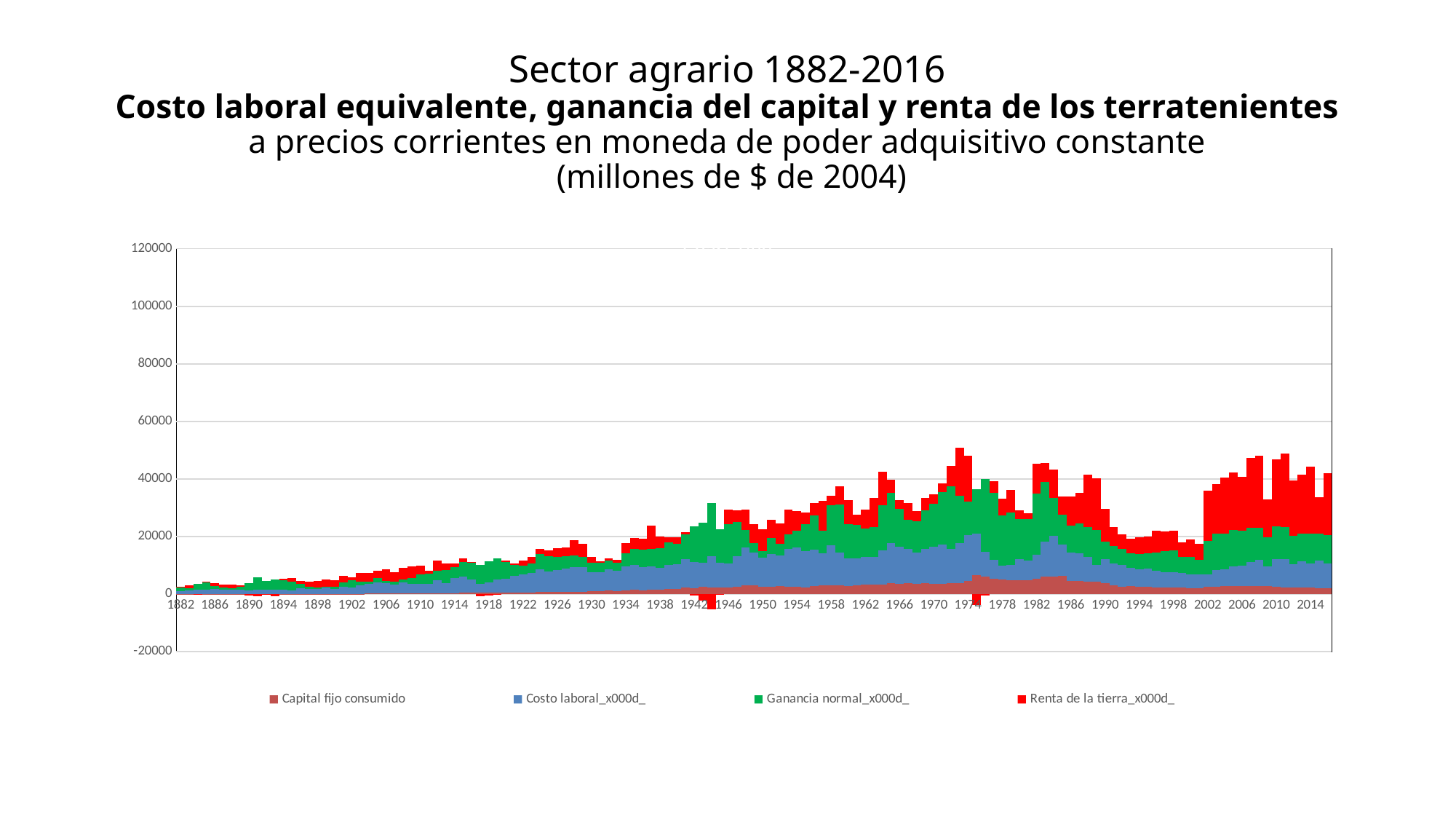
What is the highest value shown on the vertical axis? 120000 What kind of chart is shown on the slide? Stacked bar chart Which series is shown in red in the legend? Renta de la tierra_x000d_ Which series is shown in blue in the legend? Costo laboral_x000d_ What is the first year shown on the horizontal axis? 1882 How many series does the legend list? 4 Is the total stacked value for 1882 greater or less than 20000? less Is the total stacked value for 1950 greater or less than 40000? less Overall, do the stacked totals rise or fall from 1882 to 2016? rise What is the lowest value shown on the vertical axis? -20000 Is the total stacked value for 1994 greater or less than 60000? less